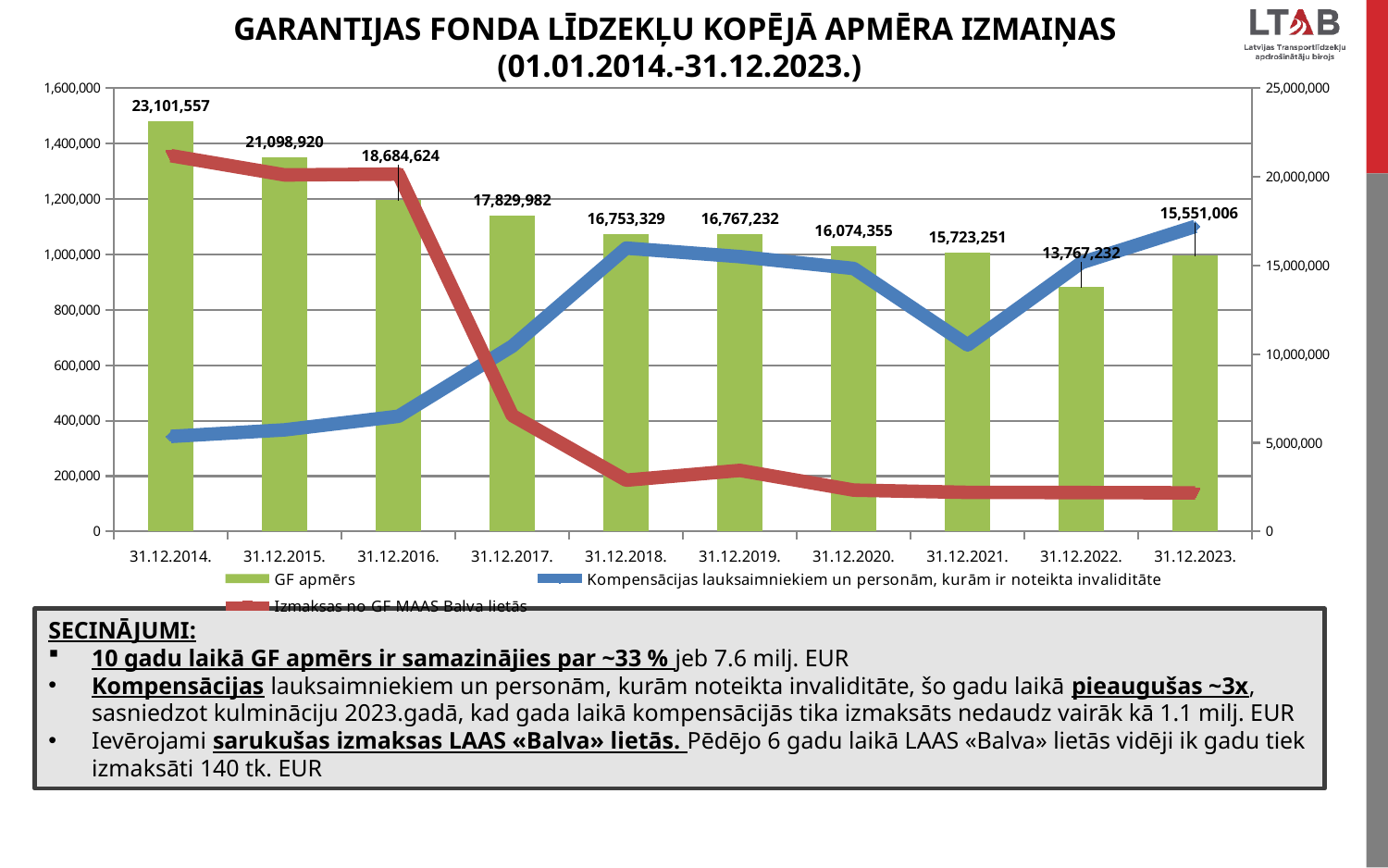
Which date has the highest GF apmērs value? 31.12.2014. What is the GF apmērs value for 31.12.2023.? 15,551,006 Is the value of the Izmaksas no GF MAAS Balva lietās line for 31.12.2014. greater or less than 1,200,000 on the left axis? greater What is the difference between the GF apmērs values for 31.12.2014. and 31.12.2023.? 7,550,551 Which date has the lowest GF apmērs value? 31.12.2022. How many dates are shown on the x axis? 10 Which is larger, the GF apmērs value for 31.12.2020. or for 31.12.2021.? 31.12.2020. How many series does the legend list? 3 What is the GF apmērs value for 31.12.2019.? 16,767,232 What is the difference between the GF apmērs values for 31.12.2023. and 31.12.2022.? 1,783,774 Is the value of the Kompensācijas lauksaimniekiem un personām, kurām ir noteikta invaliditāte line for 31.12.2014. greater or less than 400,000 on the left axis? less What is the GF apmērs value for 31.12.2014.? 23,101,557